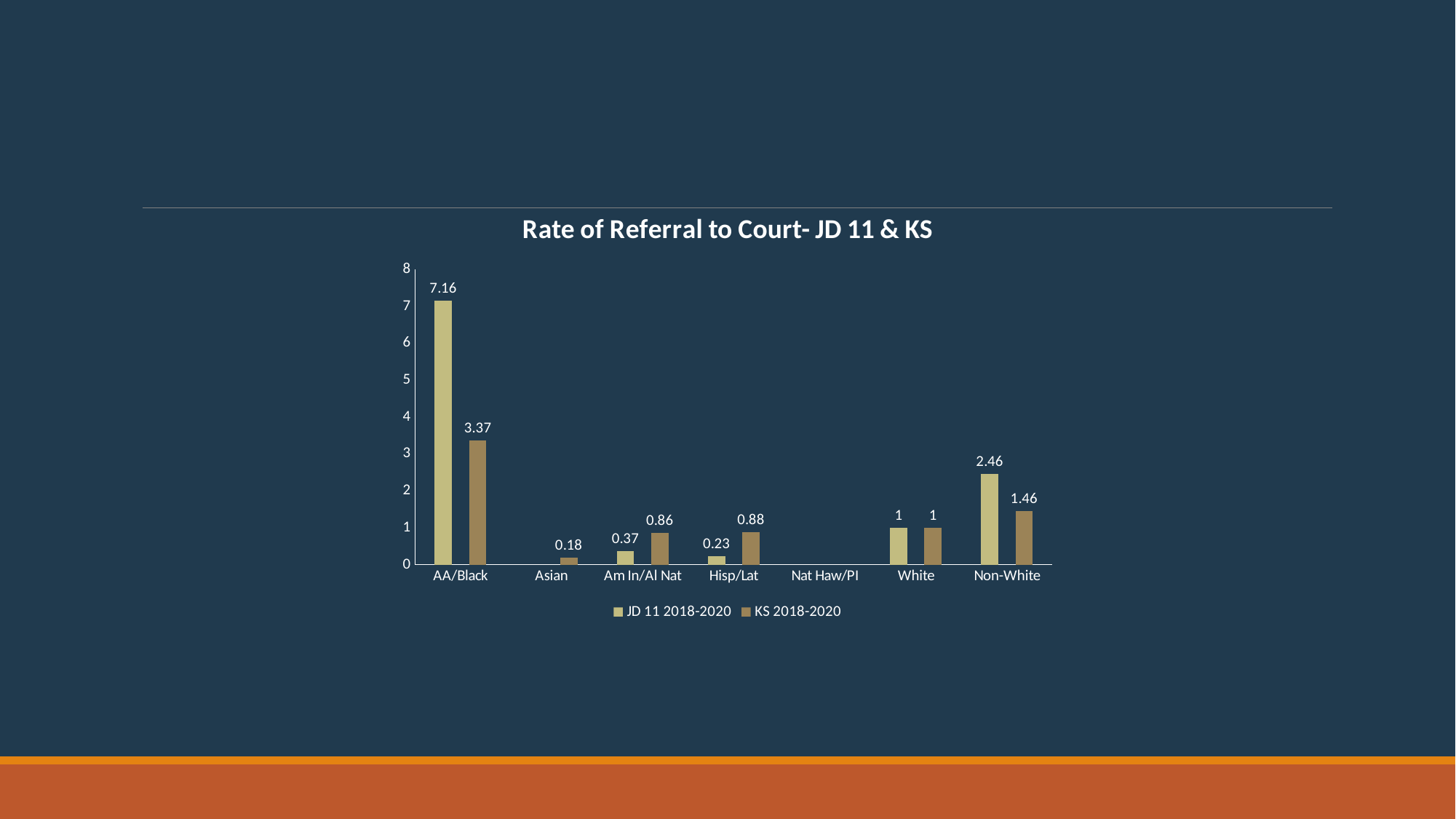
Which category has the highest JD 11 2018-2020 value? AA/Black How many series does the legend list? 2 How many categories are shown on the x axis? 7 What kind of chart is shown on the slide? Bar chart What is the difference between the JD 11 2018-2020 and KS 2018-2020 values for AA/Black? 3.79 What is the JD 11 2018-2020 value for AA/Black? 7.16 What is the KS 2018-2020 value for Hisp/Lat? 0.88 What is the KS 2018-2020 value for AA/Black? 3.37 Which is larger for Am In/Al Nat: the JD 11 2018-2020 value or the KS 2018-2020 value? KS 2018-2020 What is the JD 11 2018-2020 value for Non-White? 2.46 Which category has the lowest KS 2018-2020 value among those with a labelled bar? Asian What is the title of the chart? Rate of Referral to Court- JD 11 & KS